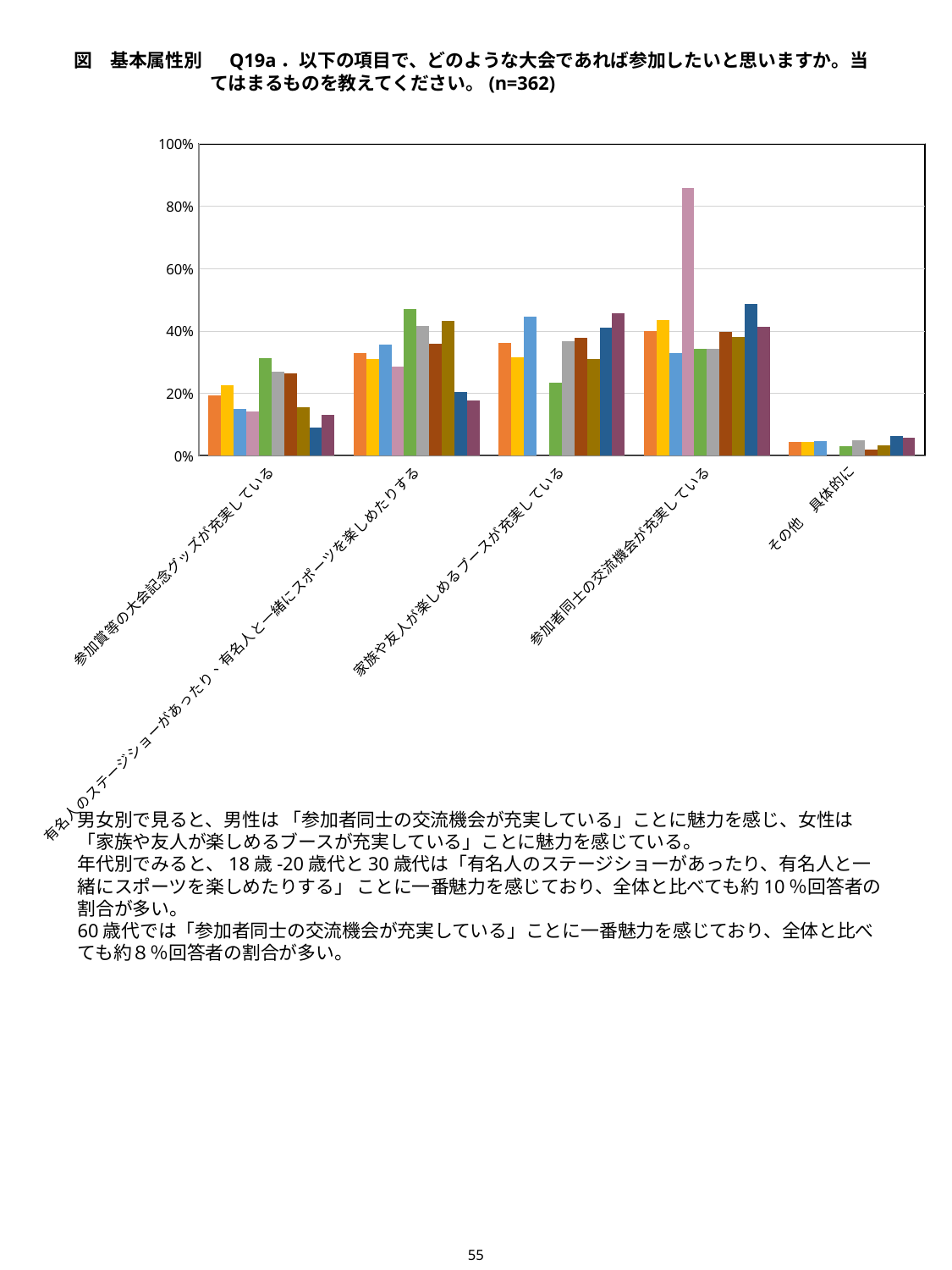
Is the tallest bar in the 参加賞等の大会記念グッズが充実している group greater or less than 40%? less How many categories are shown along the x axis of the chart? 5 Which group has taller bars overall: 参加賞等の大会記念グッズが充実している or 参加者同士の交流機会が充実している? 参加者同士の交流機会が充実している Are all the bars in the その他 具体的に group greater or less than 20%? less What is the maximum value shown on the y axis of the chart? 100% What is the sample size (n) stated in the chart title? 362 What kind of chart is shown on the slide? bar chart Is the tallest bar in the 参加者同士の交流機会が充実している group greater or less than 80%? greater Which category has the lowest bars overall in the chart? その他 具体的に Which category contains the tallest bar in the chart? 参加者同士の交流機会が充実している